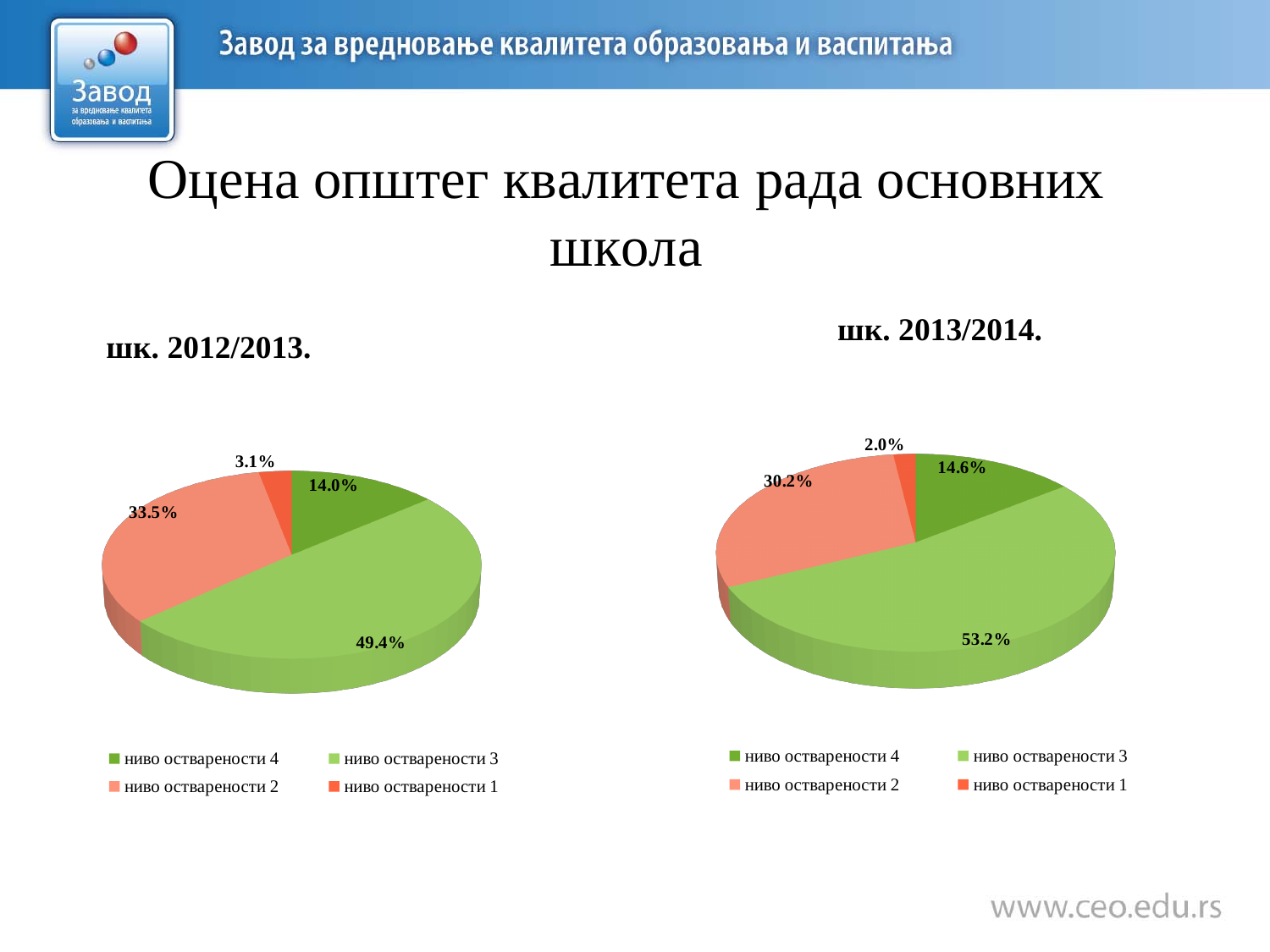
In the шк. 2012/2013 chart, what is the value for ниво остварености 3? 49.4% In the шк. 2012/2013 chart, what is the value for ниво остварености 1? 3.1% What type of chart is the шк. 2012/2013 chart? pie chart In the шк. 2012/2013 chart, what is the difference between ниво остварености 3 and ниво остварености 2? 15.9% Which is larger in the шк. 2012/2013 chart: ниво остварености 4 or ниво остварености 2? ниво остварености 2 How many entries does the legend of the шк. 2013/2014 chart list? 4 How many slices does the шк. 2013/2014 chart have? 4 In the шк. 2013/2014 chart, what is the value for ниво остварености 4? 14.6% In the шк. 2013/2014 chart, which category has the largest share? ниво остварености 3 In the шк. 2012/2013 chart, which category has the smallest share? ниво остварености 1 In the шк. 2013/2014 chart, what is the difference between ниво остварености 4 and ниво остварености 1? 12.6% In the шк. 2013/2014 chart, what is the value for ниво остварености 2? 30.2%